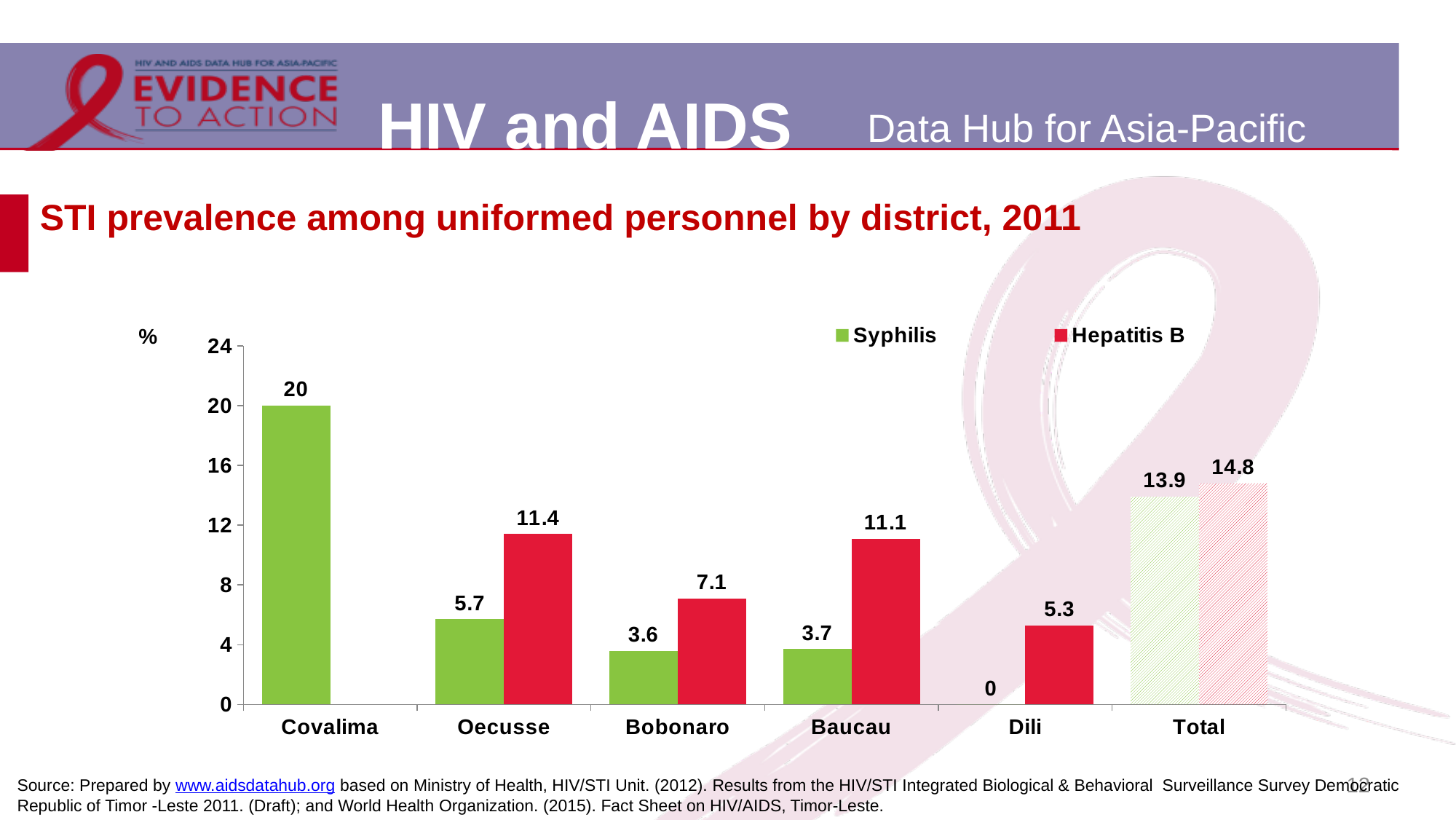
Which is larger for Bobonaro, the Syphilis value or the Hepatitis B value? Hepatitis B What kind of chart is shown on the slide? Bar chart What is the Syphilis prevalence for Dili? 0 Which district has the highest Syphilis prevalence? Covalima Which colour represents Hepatitis B in the chart? Red What is the Hepatitis B value for the Total category? 14.8 What is the difference between the Hepatitis B and Syphilis values for Baucau? 7.4 How many series does the legend list? 2 Among the districts (excluding Total), which has the highest Hepatitis B prevalence? Oecusse How many categories are shown on the x axis? 6 What is the Syphilis prevalence for Covalima? 20 What is the Hepatitis B prevalence for Oecusse? 11.4